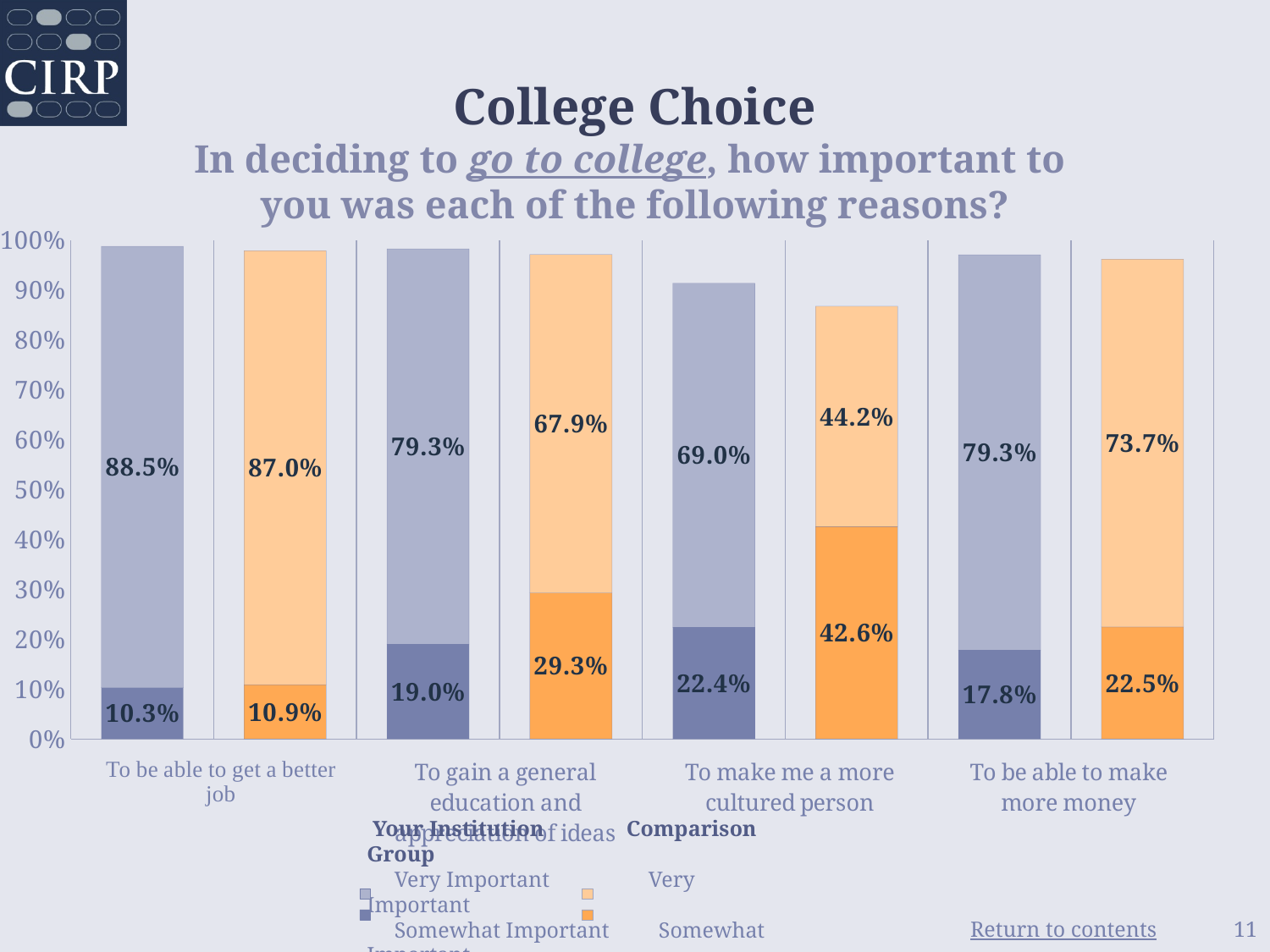
What percentage of the Comparison Group rated 'To make me a more cultured person' as Somewhat Important? 42.6% What is the combined total of Very Important and Somewhat Important for the Comparison Group for 'To make me a more cultured person'? 86.8% What is the combined total of Very Important and Somewhat Important for Your Institution for 'To be able to get a better job'? 98.8% Which reason has the lowest Very Important percentage for the Comparison Group? To make me a more cultured person How many series does the chart's legend list? 4 For 'To be able to make more money', which is larger: the Very Important percentage for Your Institution or for the Comparison Group? Your Institution What is the Very Important percentage for the Comparison Group for 'To gain a general education and appreciation of ideas'? 67.9% Which reason has the highest Very Important percentage for Your Institution? To be able to get a better job How many reasons (categories) are shown on the x axis of the chart? 4 What percentage of students at Your Institution rated 'To be able to get a better job' as Very Important? 88.5% What is the difference between Your Institution's and the Comparison Group's Very Important percentages for 'To make me a more cultured person'? 24.8% What type of chart is shown on the slide? Stacked bar chart